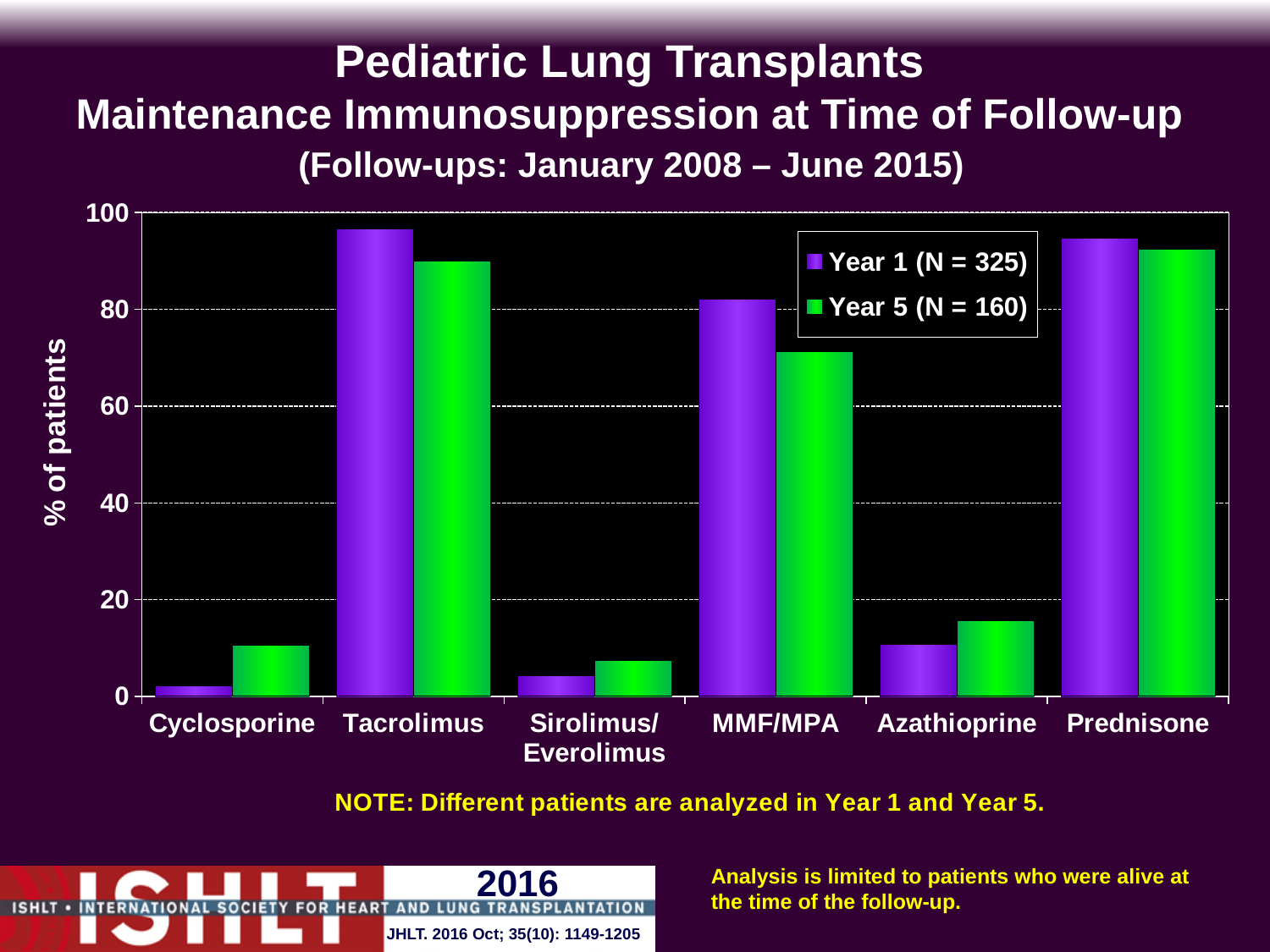
Is the Year 5 value for MMF/MPA greater or less than 60? greater For MMF/MPA, which is larger: the Year 1 value or the Year 5 value? Year 1 How many series does the legend list? 2 For Azathioprine, which is larger: the Year 1 value or the Year 5 value? Year 5 Is the Year 1 value for Azathioprine greater or less than 20? less How many drug categories are shown on the x axis? 6 Which category has the lowest Year 5 value? Sirolimus/Everolimus What is the label on the y axis? % of patients What kind of chart is shown on the slide? bar chart Is the Year 5 value for Prednisone greater or less than 80? greater Which category has the lowest Year 1 value? Cyclosporine